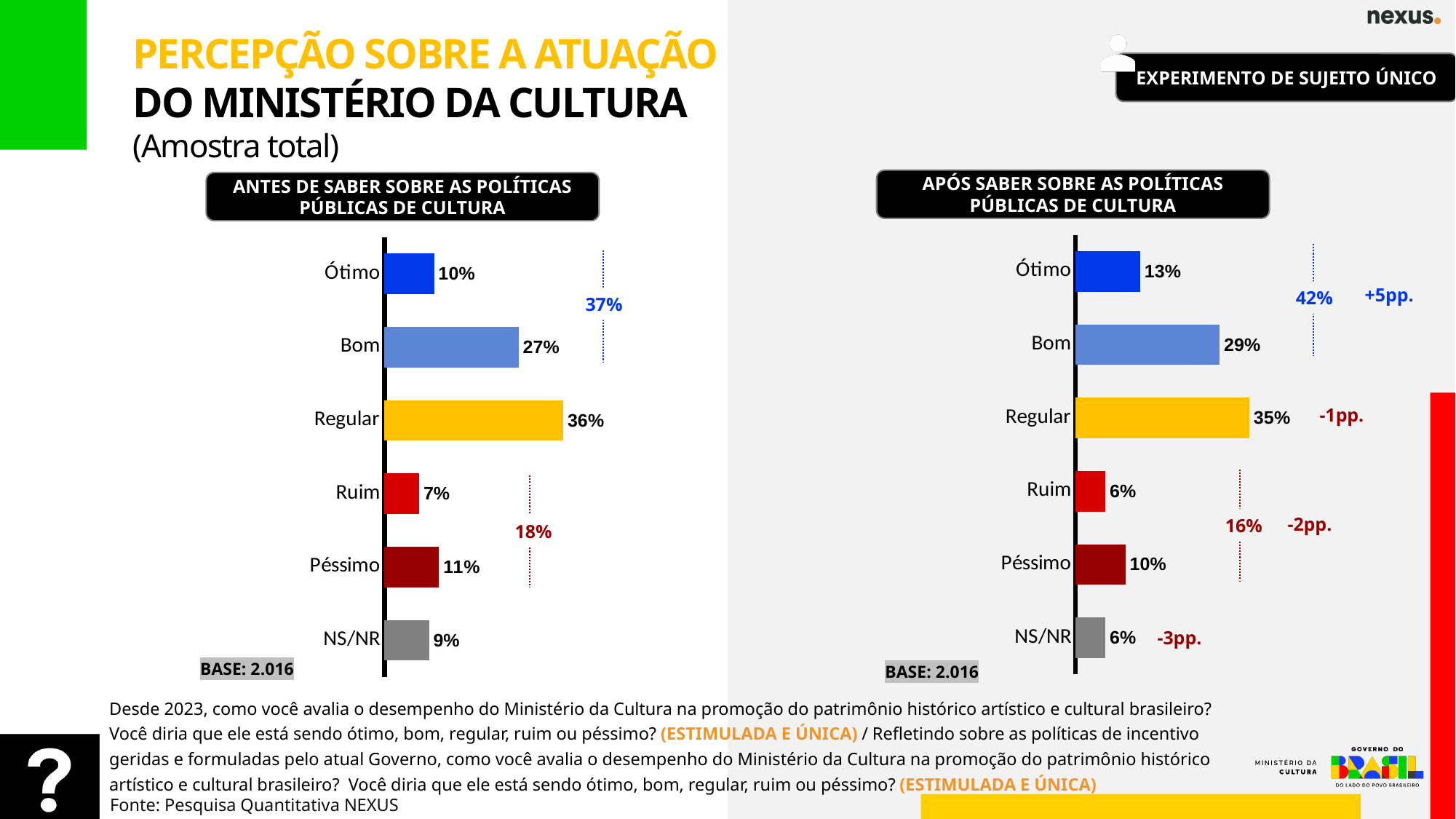
In the right chart (Após saber), which is larger: Ruim or Péssimo? Péssimo In the right chart (Após saber), what is the value for NS/NR? 6% How many categories are shown in the left chart (Antes de saber)? 6 In the left chart (Antes de saber), which category has the lowest value? Ruim What type of chart is used on this slide? Bar chart In the left chart (Antes de saber), what is the value for Péssimo? 11% In the right chart (Após saber sobre as políticas públicas de cultura), what is the value for Ótimo? 13% In the left chart (Antes de saber), which category has the highest value? Regular In the left chart (Antes de saber sobre as políticas públicas de cultura), what is the value for Regular? 36% What is the difference between the Bom values in the right chart (Após saber) and the left chart (Antes de saber)? 2 percentage points In the right chart (Após saber), which category has the highest value? Regular What is the base (sample size) shown for the right chart (Após saber)? 2.016